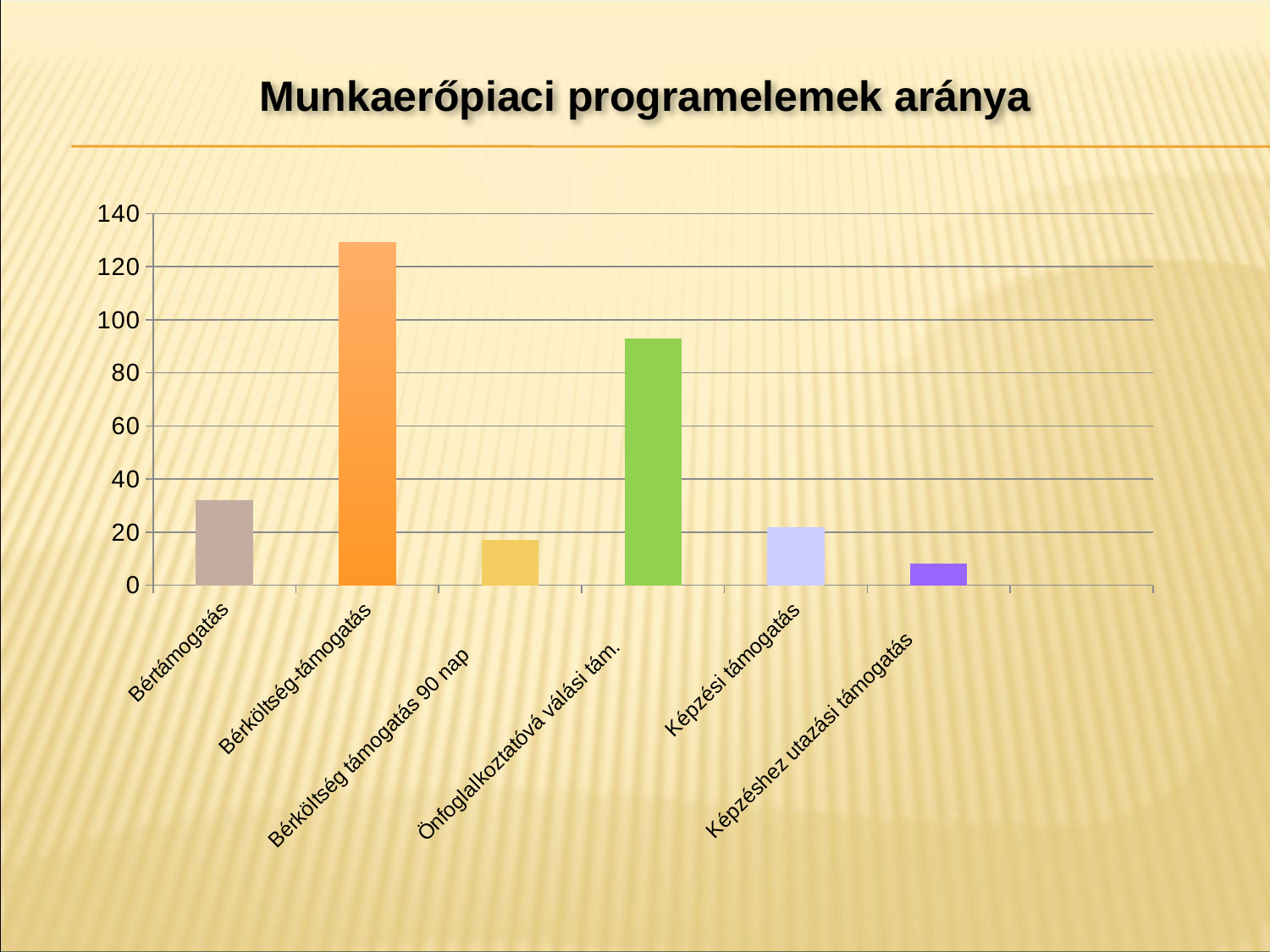
Which is larger, the value for Önfoglalkoztatóvá válási tám. or the value for Bérköltség-támogatás? Bérköltség-támogatás Is the value for Bérköltség támogatás 90 nap greater or less than 20? less Is the value for Önfoglalkoztatóvá válási tám. greater or less than 100? less What kind of chart is shown on the slide? bar chart Is the value for Bérköltség-támogatás greater or less than 120? greater Which category has the highest value? Bérköltség-támogatás What is the title of the chart? Munkaerőpiaci programelemek aránya How many categories are shown on the x axis of the chart? 6 Which is larger, the value for Bértámogatás or the value for Képzési támogatás? Bértámogatás Which category has the lowest value? Képzéshez utazási támogatás